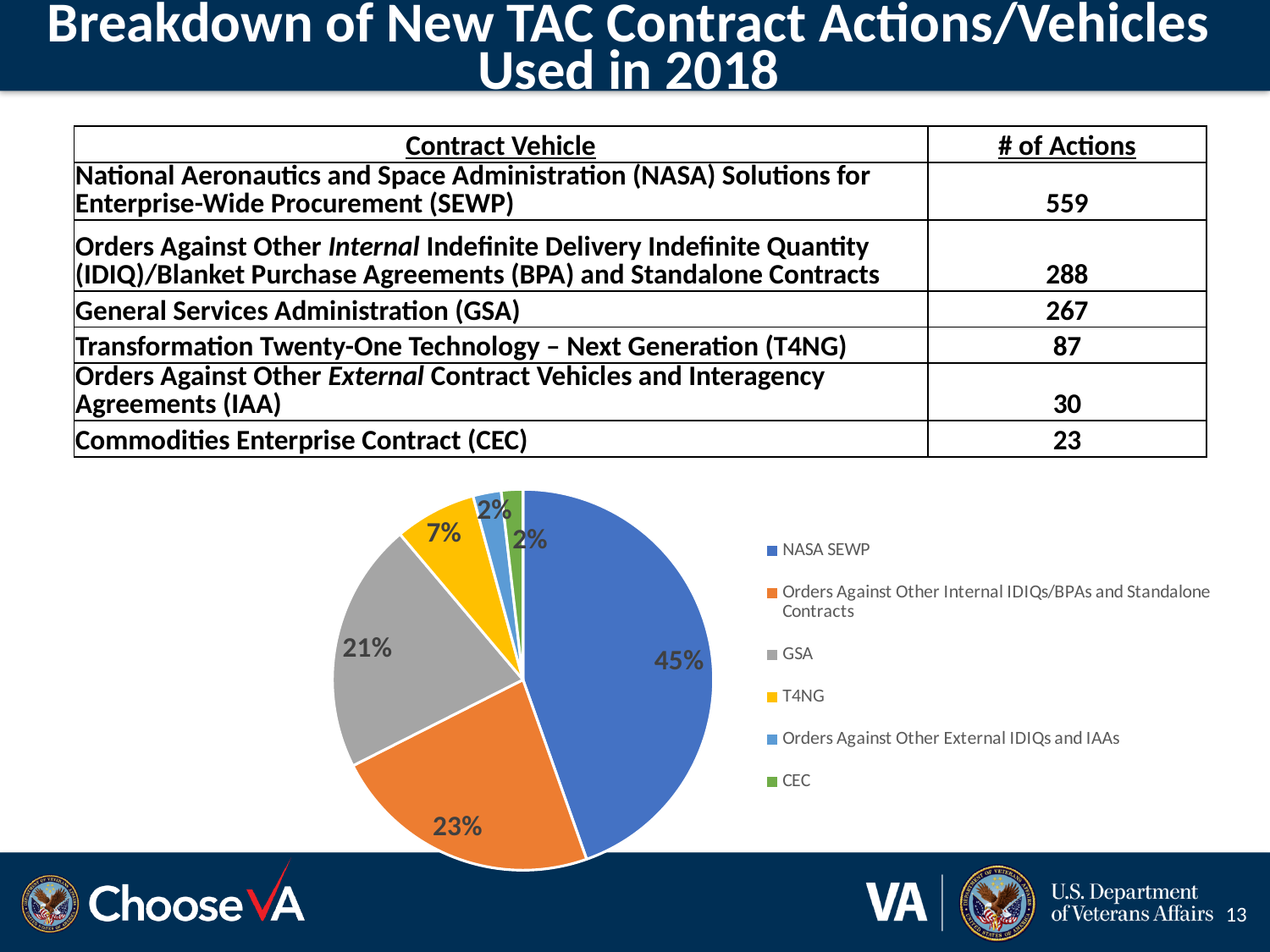
What percentage is shown for the GSA slice of the pie chart? 21% What colour is the NASA SEWP slice in the pie chart? blue What percentage is shown for the T4NG slice of the pie chart? 7% How many slices does the pie chart have? 6 Which slice is larger in the pie chart, GSA or T4NG? GSA Which category has the largest slice of the pie chart? NASA SEWP What share of the pie does NASA SEWP represent? 45% What percentage is shown for the CEC slice of the pie chart? 2% What is the difference in percentage points between the NASA SEWP slice and the Orders Against Other Internal IDIQs/BPAs and Standalone Contracts slice? 22 percentage points How many entries does the pie chart legend list? 6 What share of the pie is labelled for Orders Against Other Internal IDIQs/BPAs and Standalone Contracts? 23% What kind of chart is shown on the slide? pie chart